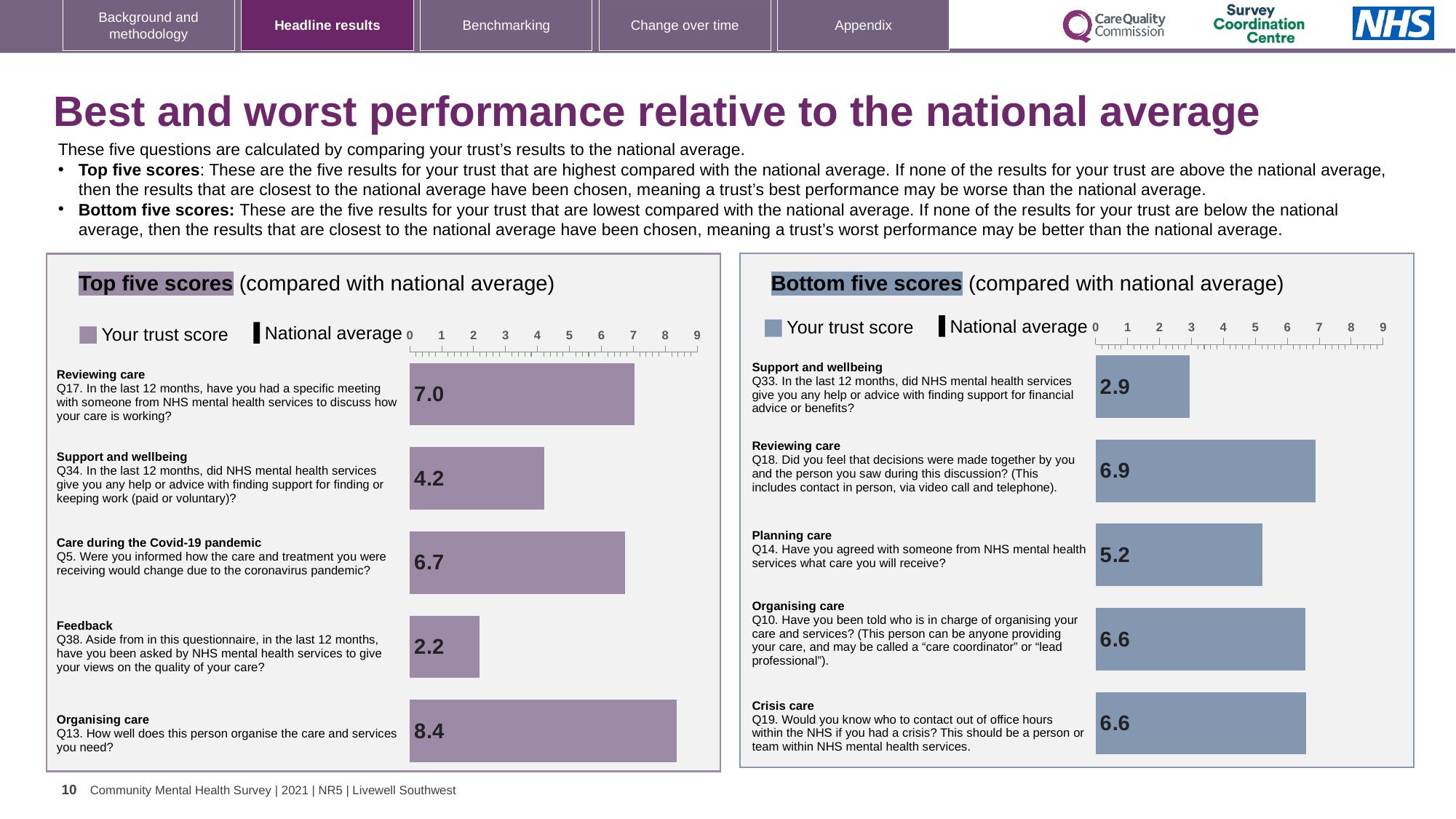
In the Bottom five scores chart, which question has the highest trust score? Reviewing care (Q18) In the Top five scores chart, what is the trust score for Organising care (Q13)? 8.4 In the Top five scores chart, which question has the highest trust score? Organising care (Q13) In the Bottom five scores chart, which has the larger trust score: Planning care (Q14) or Organising care (Q10)? Organising care (Q10) In the Top five scores chart, what is the trust score for Feedback (Q38)? 2.2 In the Bottom five scores chart, what is the trust score for Support and wellbeing (Q33)? 2.9 In the Top five scores chart, is the trust score for Care during the Covid-19 pandemic (Q5) greater or less than 5? greater In the Top five scores chart, which question has the lowest trust score? Feedback (Q38) What type of chart is the Bottom five scores chart? Bar chart How many bars are plotted in the Top five scores chart? 5 In the Bottom five scores chart, which question has the lowest trust score? Support and wellbeing (Q33) In the Top five scores chart, what is the difference between the trust scores for Reviewing care (Q17) and Support and wellbeing (Q34)? 2.8